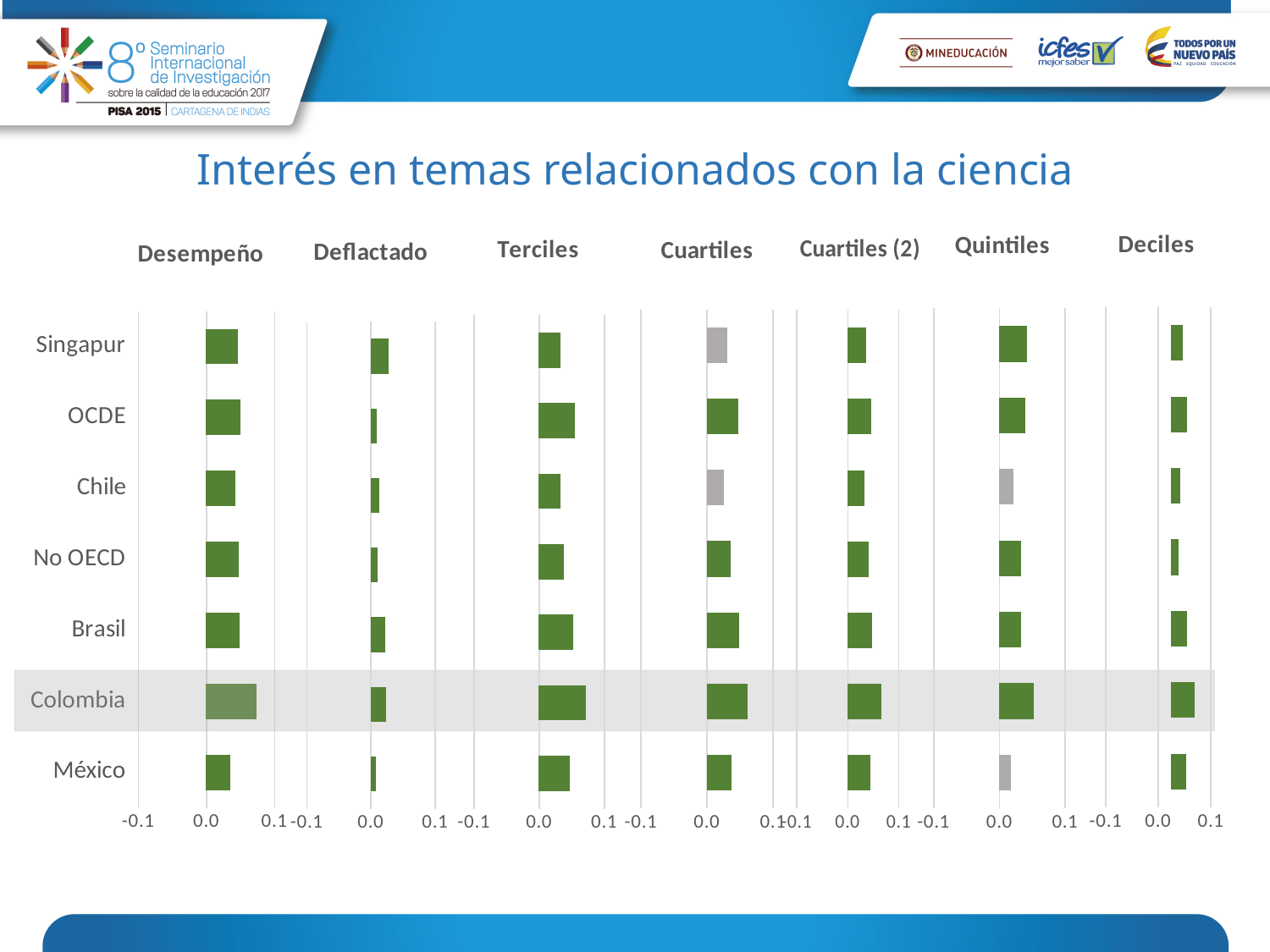
In the Desempeño panel, which is larger, the value for Colombia or the value for México? Colombia What is the title of the slide's chart? Interés en temas relacionados con la ciencia How many countries or groups are listed as categories in the Desempeño panel? 7 How many panels (Desempeño, Deflactado, etc.) are shown on the slide? 7 In the Deciles panel, which category has the lowest value? No OECD In the Desempeño panel, which category has the highest value? Colombia In the Deflactado panel, which is larger, the value for Singapur or the value for OCDE? Singapur In the Terciles panel, which category has the highest value? Colombia In the Cuartiles panel, is the value for Brasil greater or less than 0.0? greater In the Desempeño panel, is the value for Colombia greater or less than 0.1? less In the Deflactado panel, which category has the highest value? Singapur What kind of chart is used in each panel of the slide? Bar chart